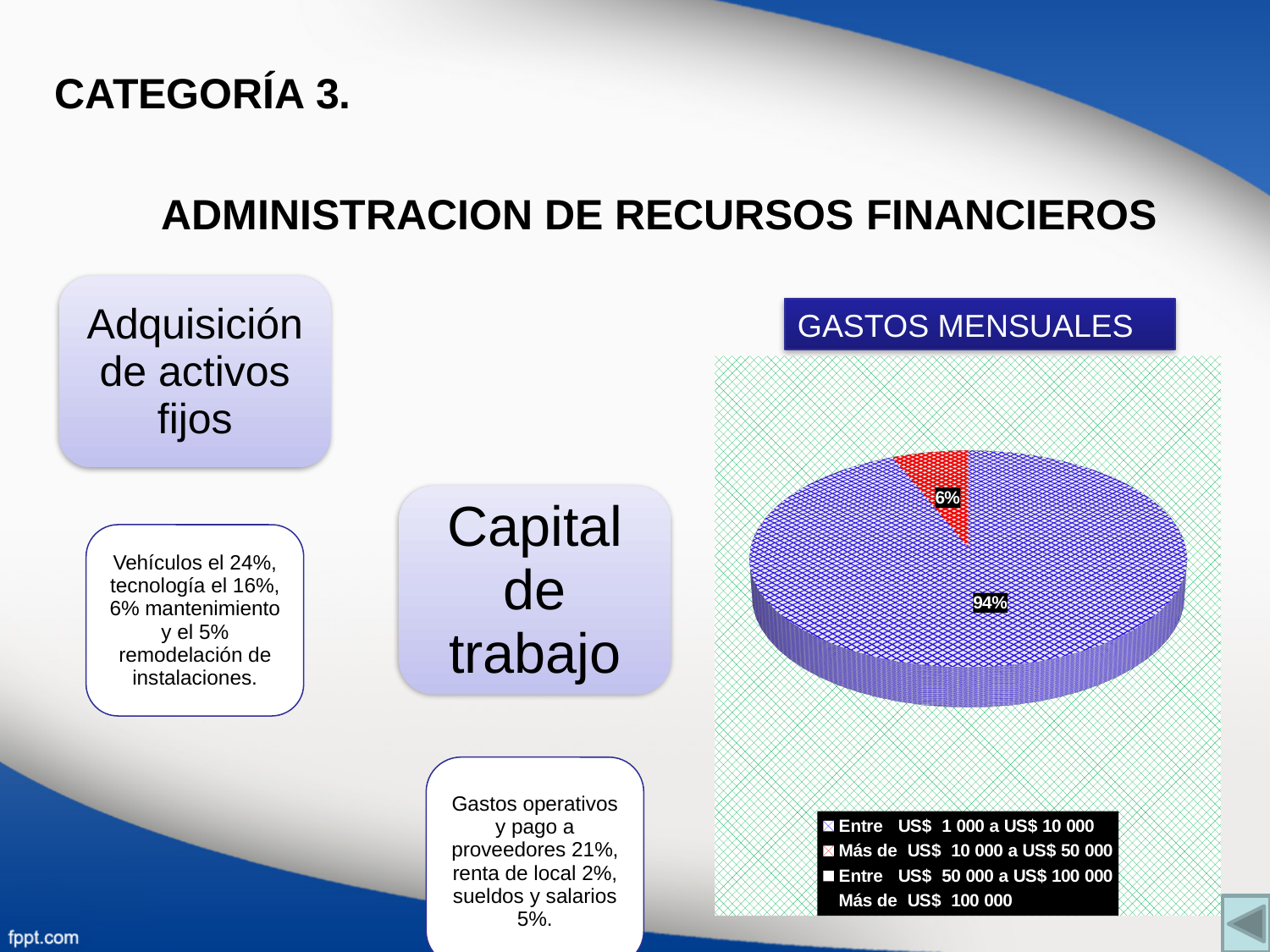
In the GASTOS MENSUALES pie chart, what is the difference between the largest and smallest slice values? 88 percentage points How many entries does the legend of the GASTOS MENSUALES chart list? 4 What is the title of the chart on the right of the slide? GASTOS MENSUALES In the GASTOS MENSUALES pie chart, is the largest slice greater or less than 50%? greater In the GASTOS MENSUALES pie chart, which slice is larger, the blue one or the red one? The blue one In the GASTOS MENSUALES pie chart, what do the two labelled slices add up to? 100% In the GASTOS MENSUALES pie chart, what is the value of the smallest slice? 6% In the GASTOS MENSUALES pie chart, what is the value of the largest slice? 94% In the GASTOS MENSUALES pie chart, what colour is the 6% slice? Red What kind of chart is shown under the title GASTOS MENSUALES? Pie chart How many slices with data labels are visible in the GASTOS MENSUALES pie chart? 2